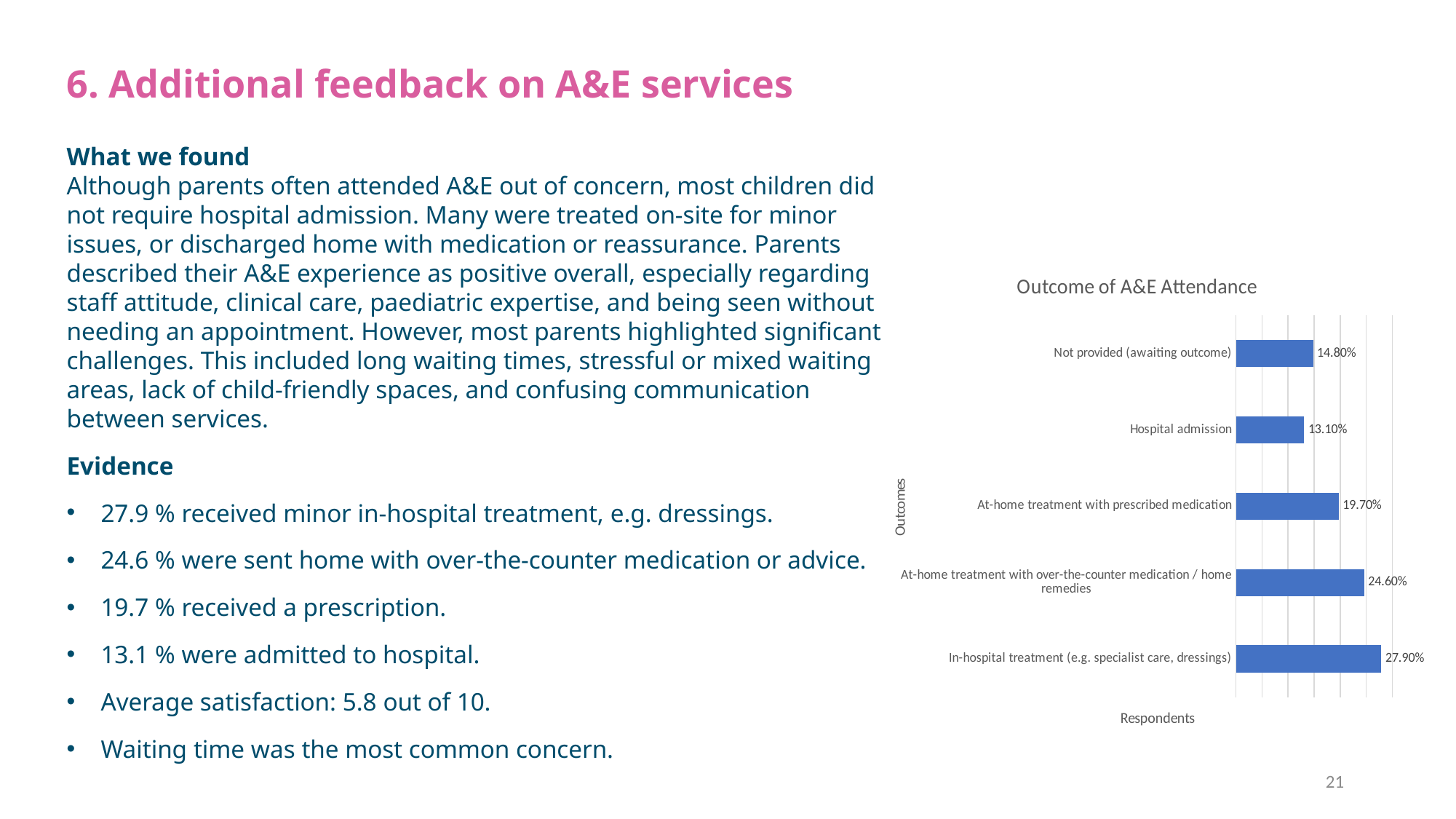
What is the value for Not provided (awaiting outcome)? 14.80% What is the title of the chart? Outcome of A&E Attendance What is the value for In-hospital treatment (e.g. specialist care, dressings)? 27.90% Which outcome has the lowest value? Hospital admission Which outcome has the highest value? In-hospital treatment (e.g. specialist care, dressings) Which is larger: the value for Not provided (awaiting outcome) or the value for Hospital admission? Not provided (awaiting outcome) What is the label on the horizontal axis of the chart? Respondents What is the value for At-home treatment with prescribed medication? 19.70% How many outcome categories are shown in the chart? 5 What is the value for Hospital admission in the Outcome of A&E Attendance chart? 13.10% What is the difference between the values for In-hospital treatment and At-home treatment with over-the-counter medication / home remedies? 3.30% What kind of chart is shown on the slide? Bar chart